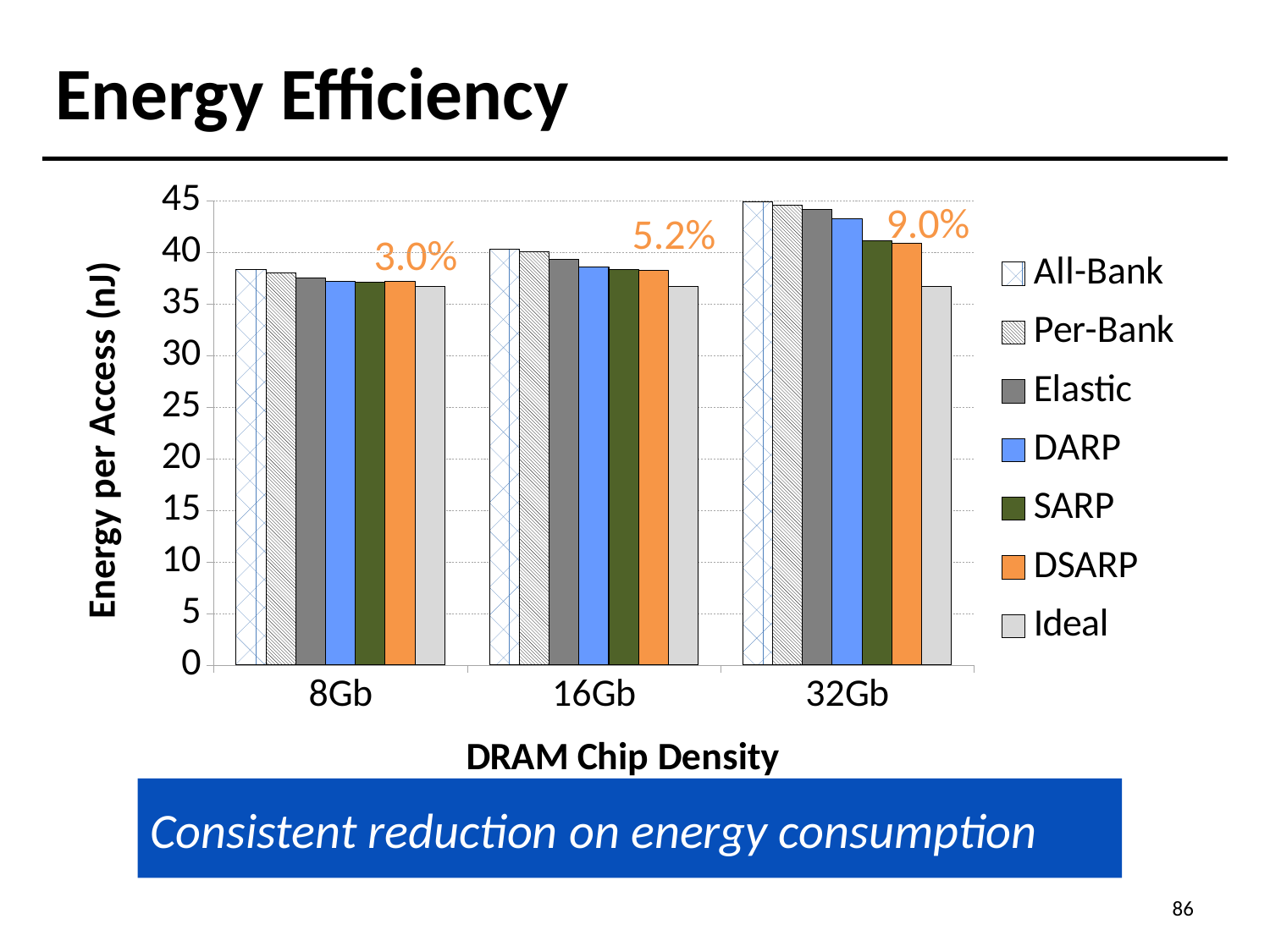
What is the label of the y axis? Energy per Access (nJ) Is the value for All-Bank at 8Gb greater or less than 35? greater Does the energy per access for All-Bank rise or fall as DRAM chip density increases from 8Gb to 32Gb? rise What percentage annotation is printed above the 8Gb group? 3.0% What kind of chart is shown on the slide? bar chart What percentage annotation is printed above the 16Gb group? 5.2% How many series does the legend list? 7 Which series has the highest energy per access at 32Gb? All-Bank How many DRAM chip density categories are shown on the x axis? 3 What percentage annotation is printed above the 32Gb group? 9.0% Which series has the lowest energy per access at 32Gb? Ideal Is the value for DSARP at 16Gb greater or less than 40? less